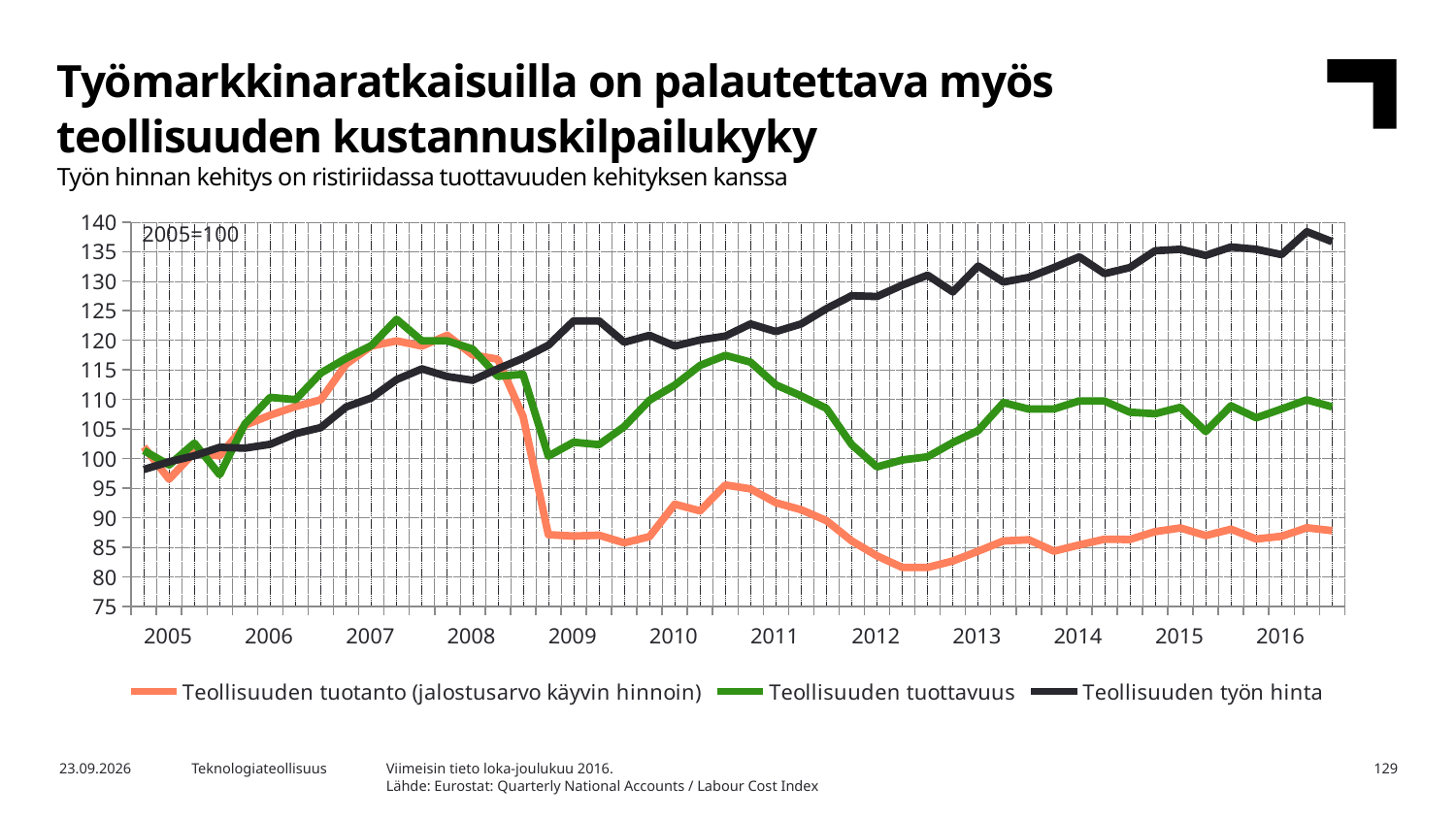
Is the value for Teollisuuden tuottavuus at the end of 2016 greater or less than 105? greater Is the value for Teollisuuden tuotanto (jalostusarvo käyvin hinnoin) in 2012 greater or less than 90? less Is the value for Teollisuuden työn hinta at the end of 2016 greater or less than 130? greater Does the Teollisuuden työn hinta series rise or fall overall from 2005 to 2016? rise How many series does the legend list? 3 How many years are labelled on the x axis? 12 What base year and index value is noted in the top-left corner of the chart? 2005=100 Which series has the highest value at the end of 2016? Teollisuuden työn hinta Which series has the lowest value at the end of 2016? Teollisuuden tuotanto (jalostusarvo käyvin hinnoin) What kind of chart is shown on the slide? line chart At the end of 2016, which is larger: Teollisuuden työn hinta or Teollisuuden tuotanto (jalostusarvo käyvin hinnoin)? Teollisuuden työn hinta